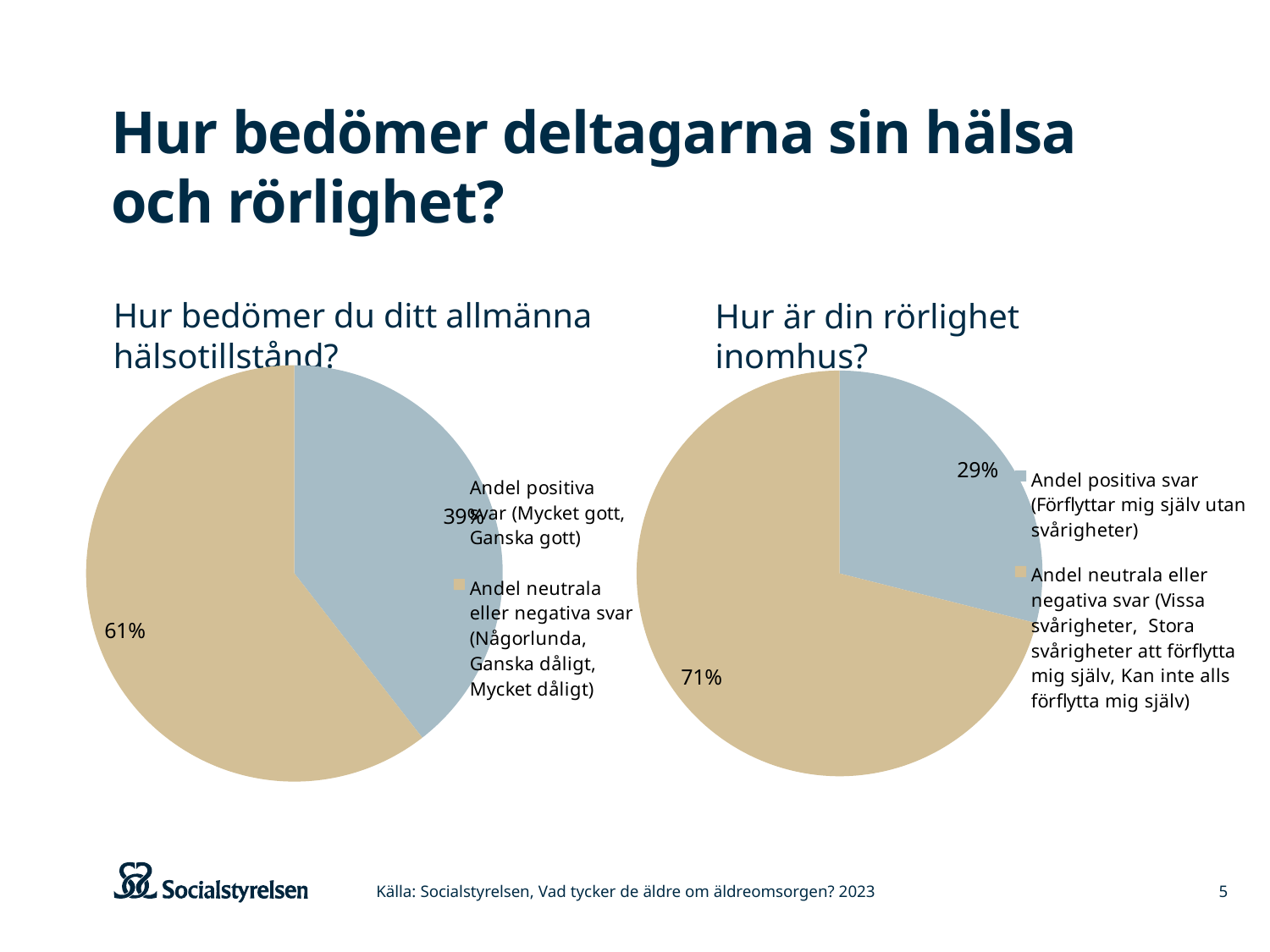
In the right pie chart ("Hur är din rörlighet inomhus?"), what share is labelled for "Andel positiva svar"? 29% In the right pie chart ("Hur är din rörlighet inomhus?"), what is the difference in percentage points between the neutral/negative share and the positive share? 42 percentage points How many slices does the right pie chart ("Hur är din rörlighet inomhus?") have? 2 In the left pie chart ("Hur bedömer du ditt allmänna hälsotillstånd?"), which category has the largest slice? Andel neutrala eller negativa svar In the left pie chart ("Hur bedömer du ditt allmänna hälsotillstånd?"), what is the difference in percentage points between the neutral/negative share and the positive share? 22 percentage points In the left pie chart ("Hur bedömer du ditt allmänna hälsotillstånd?"), what share is labelled for "Andel positiva svar"? 39% In the left pie chart ("Hur bedömer du ditt allmänna hälsotillstånd?"), what share is labelled for "Andel neutrala eller negativa svar"? 61% What kind of chart is used on the left of the slide, titled "Hur bedömer du ditt allmänna hälsotillstånd?"? Pie chart In the right pie chart ("Hur är din rörlighet inomhus?"), what share is labelled for "Andel neutrala eller negativa svar"? 71% In the right pie chart ("Hur är din rörlighet inomhus?"), which category has the smallest slice? Andel positiva svar In the left pie chart ("Hur bedömer du ditt allmänna hälsotillstånd?"), what colour is the slice for "Andel positiva svar"? Blue-grey Which chart shows a larger share of positive answers: the left chart ("Hur bedömer du ditt allmänna hälsotillstånd?") or the right chart ("Hur är din rörlighet inomhus?")? The left chart (39% vs 29%)